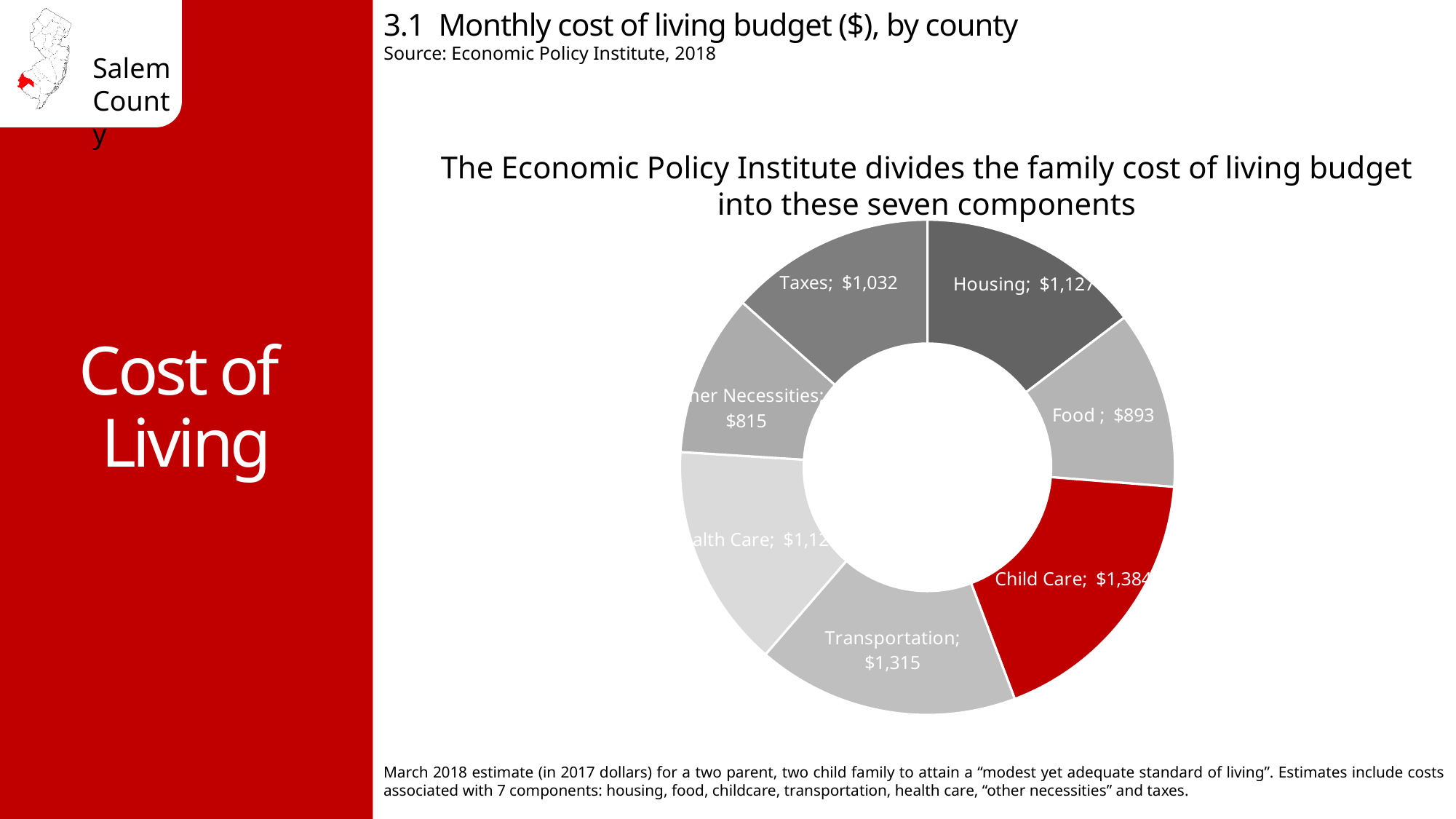
What is the monthly cost for Taxes shown on the chart? $1,032 What is the monthly cost for Other Necessities shown on the chart? $815 What is the difference between the Transportation and Taxes values? $283 What kind of chart is shown on the slide? Doughnut (pie) chart Which component has the smallest slice of the chart? Other Necessities Which component has the largest slice of the chart? Child Care What is the monthly cost for Food shown on the chart? $893 What is the difference between the Food and Other Necessities values? $78 What is the monthly cost for Transportation shown on the chart? $1,315 Which is larger, the value for Transportation or the value for Taxes? Transportation Which component is shown in red on the chart? Child Care How many components are shown in the chart? 7